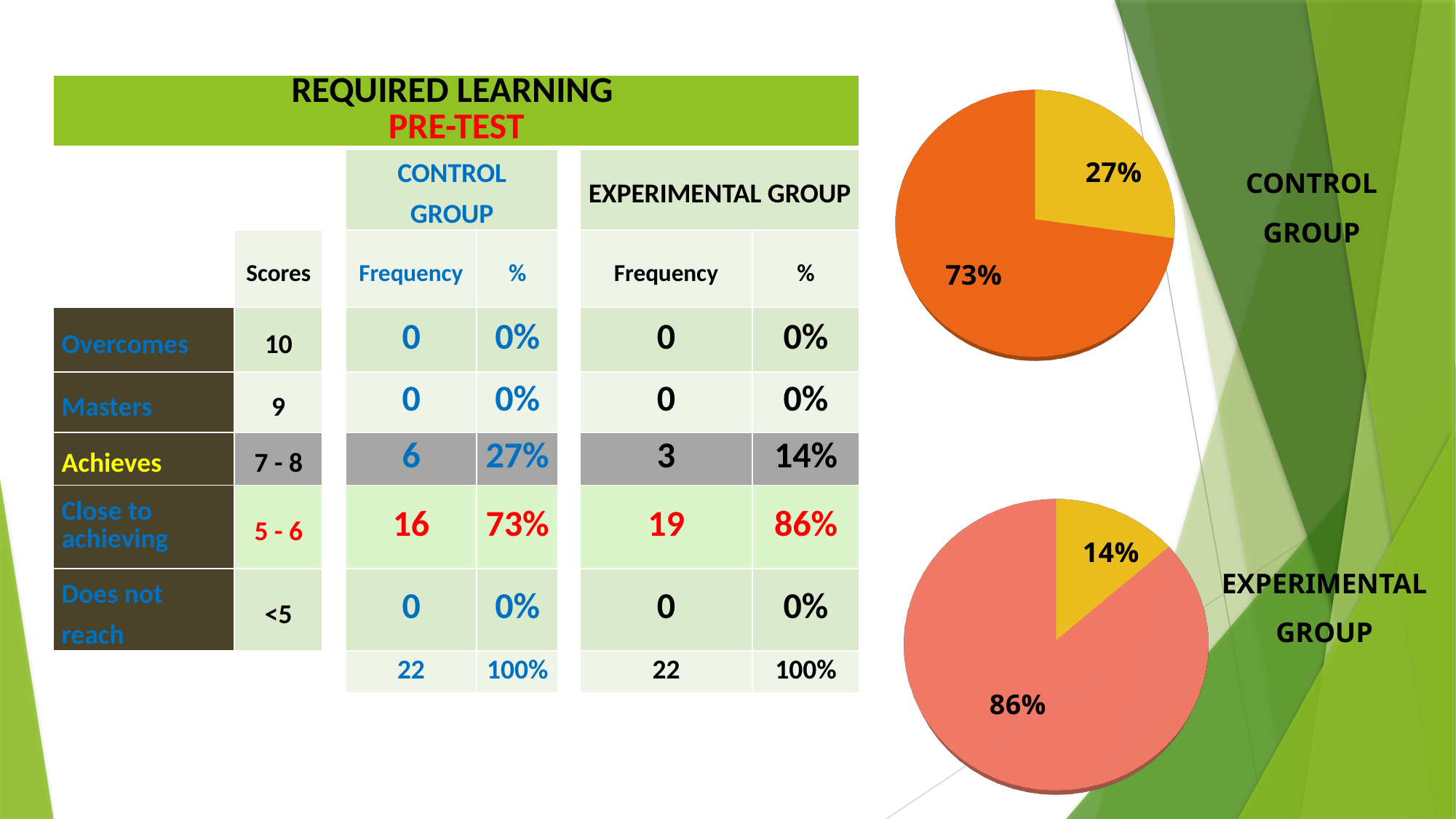
How many slices does the Control Group pie chart have? 2 In the Experimental Group pie chart, what is the value of the smallest slice? 14% In the Control Group pie chart, what is the value of the largest slice? 73% In the Experimental Group pie chart, what is the value of the largest slice? 86% Which pie chart has the larger dominant slice, the Control Group chart or the Experimental Group chart? Experimental Group In the Experimental Group pie chart, what is the difference between the two slices' values? 72 percentage points What colour is the 86% slice in the Experimental Group pie chart? salmon pink In the Control Group pie chart, what share of the pie does the yellow slice represent? 27% In the Control Group pie chart, what is the difference between the two slices' values? 46 percentage points How many slices does the Experimental Group pie chart have? 2 What kind of chart is the Control Group chart on the right of the slide? pie chart In the Control Group pie chart, what is the value of the smallest slice? 27%